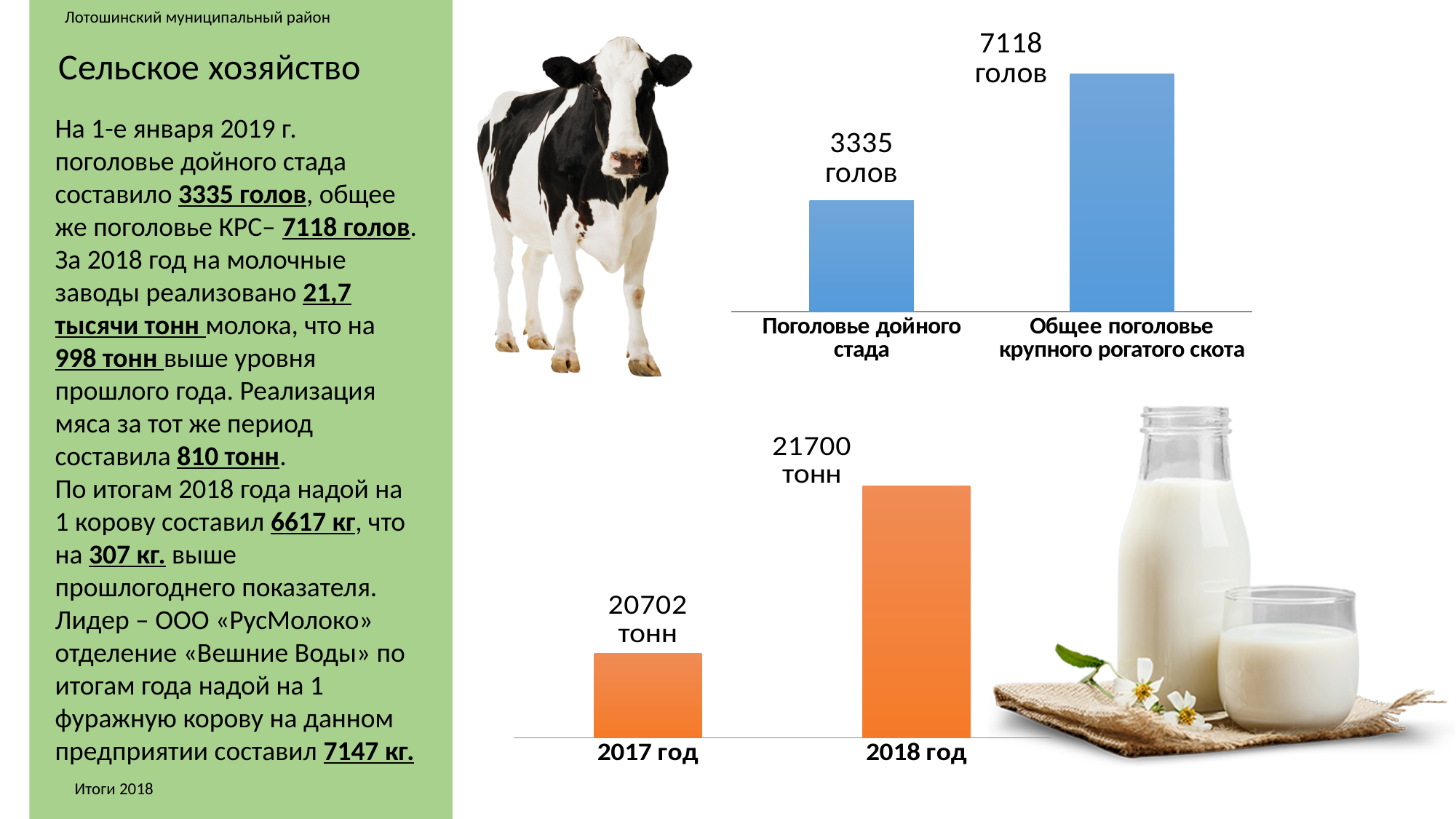
What colour are the bars in the bottom chart? Orange In the bottom chart, which year has the lower value? 2017 год In the bottom chart, do the values rise or fall from 2017 год to 2018 год? Rise In the bottom chart, what is the value for 2017 год? 20702 тонн In the top chart, which category has the higher value? Общее поголовье крупного рогатого скота In the top chart, how many bars are plotted? 2 In the top chart, what is the value for Общее поголовье крупного рогатого скота? 7118 голов In the top chart, what is the value for Поголовье дойного стада? 3335 голов In the bottom chart, what is the value for 2018 год? 21700 тонн In the top chart, what is the difference between Общее поголовье крупного рогатого скота and Поголовье дойного стада? 3783 голов In the bottom chart, what is the difference between 2018 год and 2017 год? 998 тонн What type of chart is the top chart? Bar chart